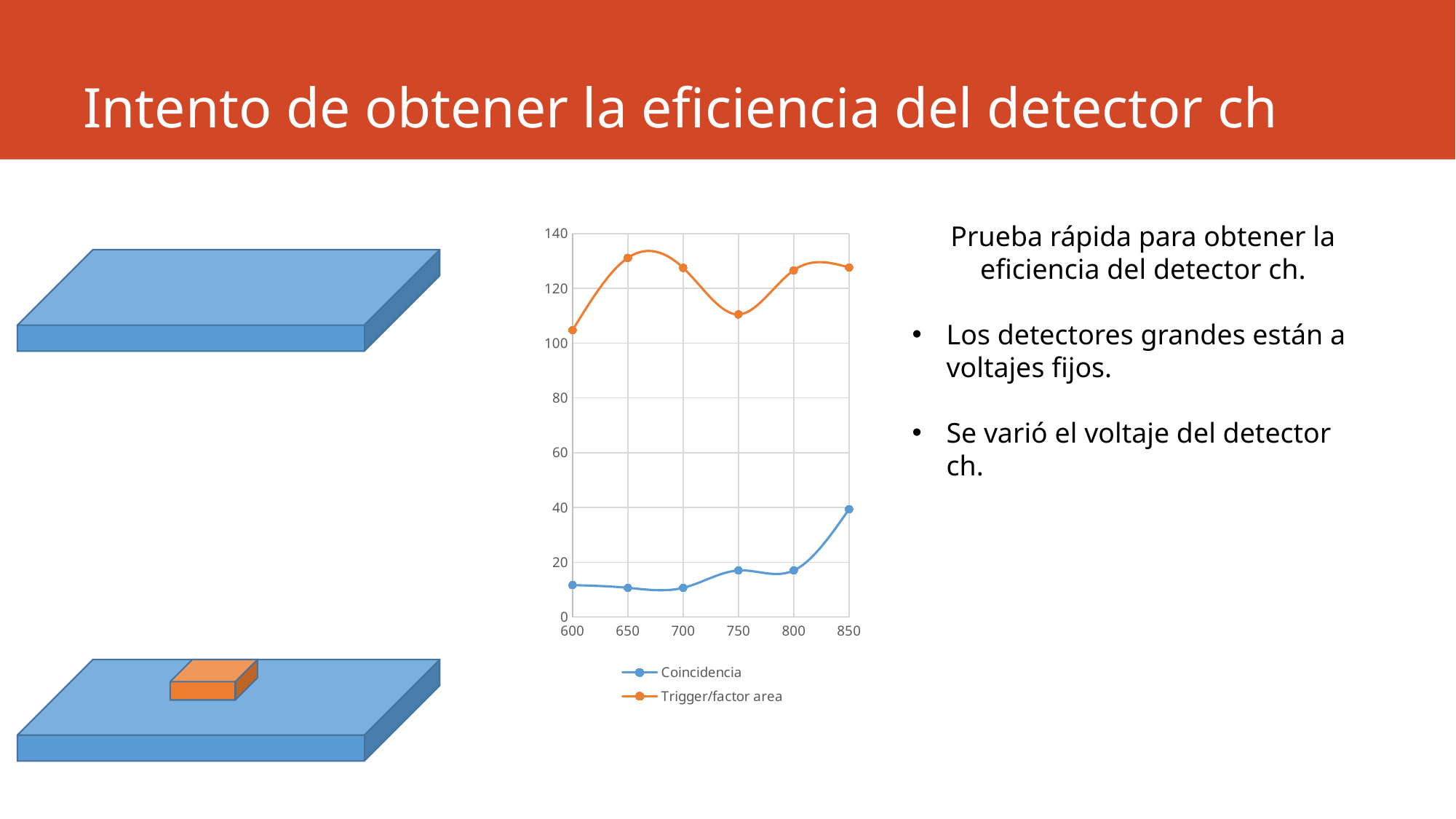
Does the Coincidencia series end higher or lower at 850 than it starts at 600? higher Is the value of Coincidencia at 850 greater or less than 60? less What are the two series named in the chart's legend? Coincidencia and Trigger/factor area Is the value of Trigger/factor area at 600 greater or less than 100? greater Which series is drawn in orange in the chart? Trigger/factor area At 650, which series has the larger value, Coincidencia or Trigger/factor area? Trigger/factor area Is the value of Coincidencia at 600 greater or less than 20? less How many series does the chart's legend list? 2 At which x value does the Coincidencia series reach its highest value? 850 What kind of chart is shown on the slide? line chart How many x-axis points are plotted for each series in the chart? 6